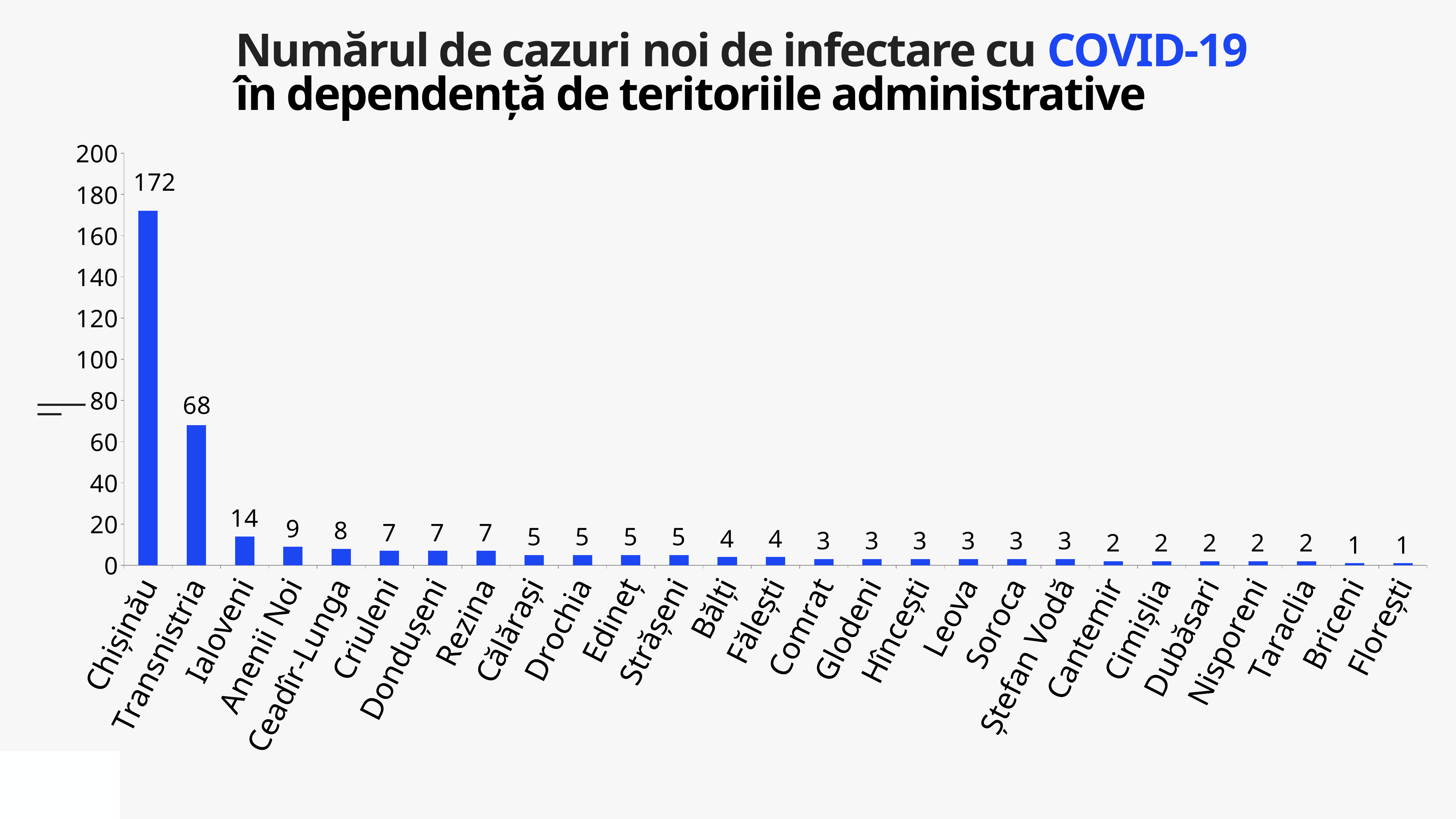
What is the value for Anenii Noi? 9 What is the highest tick value shown on the vertical axis? 200 Which territory has the highest number of new cases? Chișinău What is the difference between the values for Chișinău and Transnistria? 104 How many territories are shown on the x axis? 27 What is the value for Chișinău? 172 Do the values rise or fall from left to right along the x axis? Fall Which is larger, the value for Ceadîr-Lunga or the value for Rezina? Ceadîr-Lunga What is the value for Briceni? 1 What is the value for Transnistria? 68 What is the value for Ialoveni? 14 What kind of chart is this? Bar chart